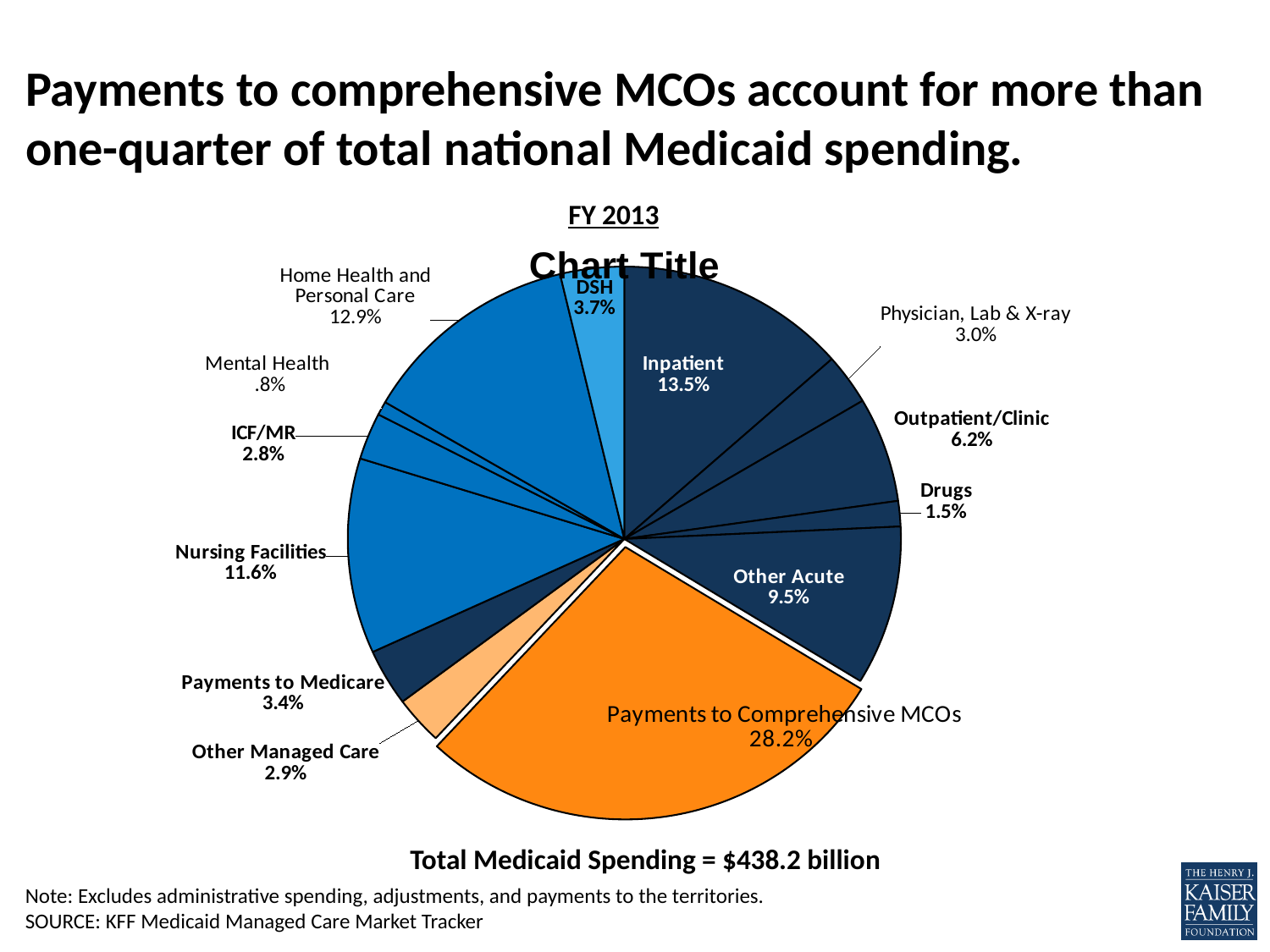
What percentage of spending is for Inpatient? 13.5% What percentage of spending is for Drugs? 1.5% What percentage of spending is for Nursing Facilities? 11.6% What share of total Medicaid spending goes to Payments to Comprehensive MCOs? 28.2% What type of chart is shown on the slide? pie chart Which is larger, the share for Home Health and Personal Care or the share for Nursing Facilities? Home Health and Personal Care Which category accounts for the largest share of Medicaid spending? Payments to Comprehensive MCOs Which category accounts for the smallest share of Medicaid spending? Mental Health What fiscal year does the chart cover? FY 2013 How many categories are shown in the pie chart? 13 What is the total Medicaid spending stated below the chart? $438.2 billion What is the difference in percentage points between Inpatient and Other Acute? 4.0